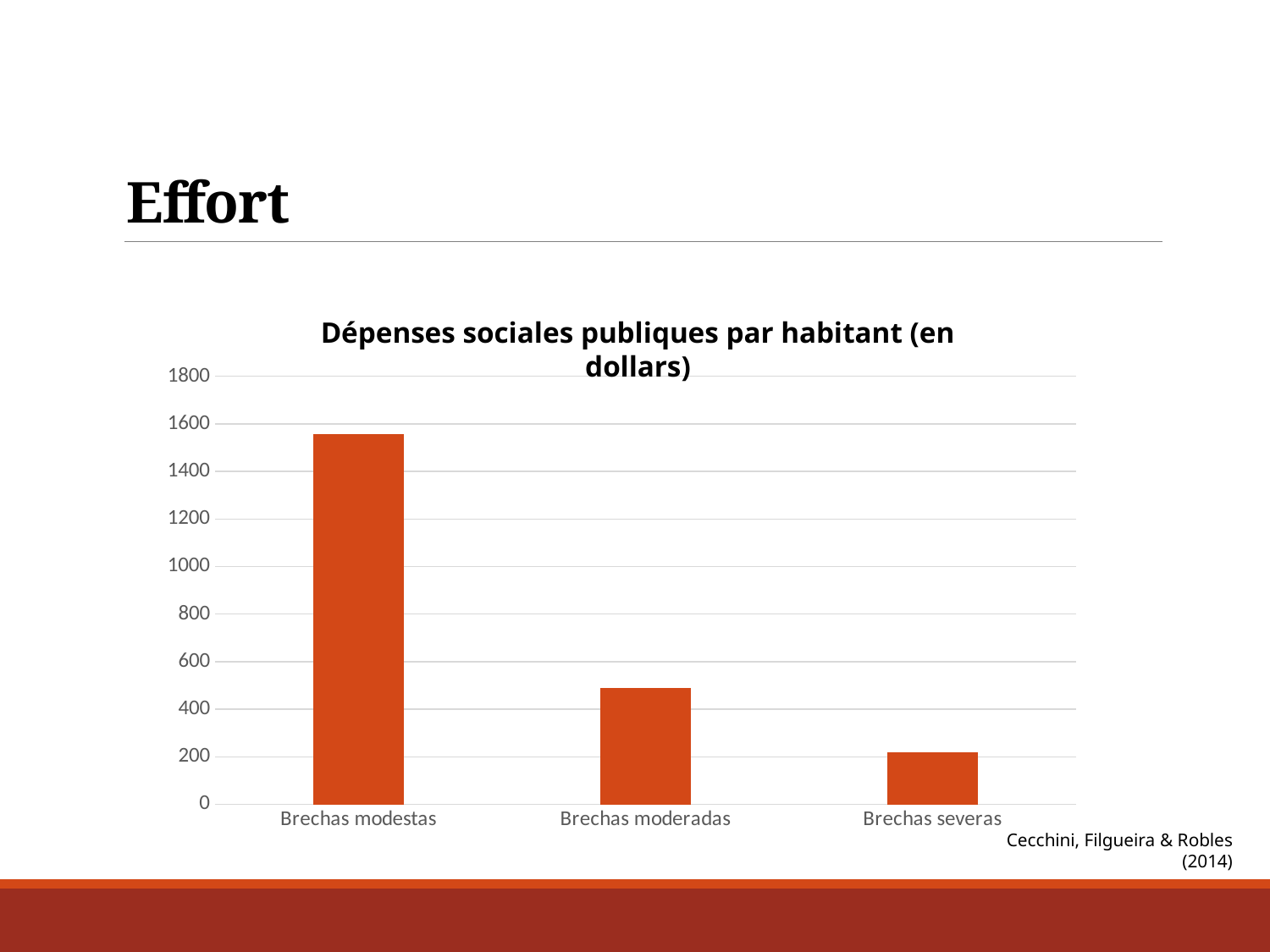
Is the value for Brechas modestas greater or less than 1600? less How many categories are shown on the x axis of the chart? 3 What is the title of the chart? Dépenses sociales publiques par habitant (en dollars) Do the values rise or fall from left to right along the x axis? fall Is the value for Brechas moderadas greater or less than 600? less What kind of chart is shown on the slide? bar chart Which is larger, the value for Brechas moderadas or the value for Brechas severas? Brechas moderadas Which category has the highest value? Brechas modestas Which category has the lowest value? Brechas severas Is the value for Brechas modestas greater or less than 1400? greater What is the highest value shown on the y axis of the chart? 1800